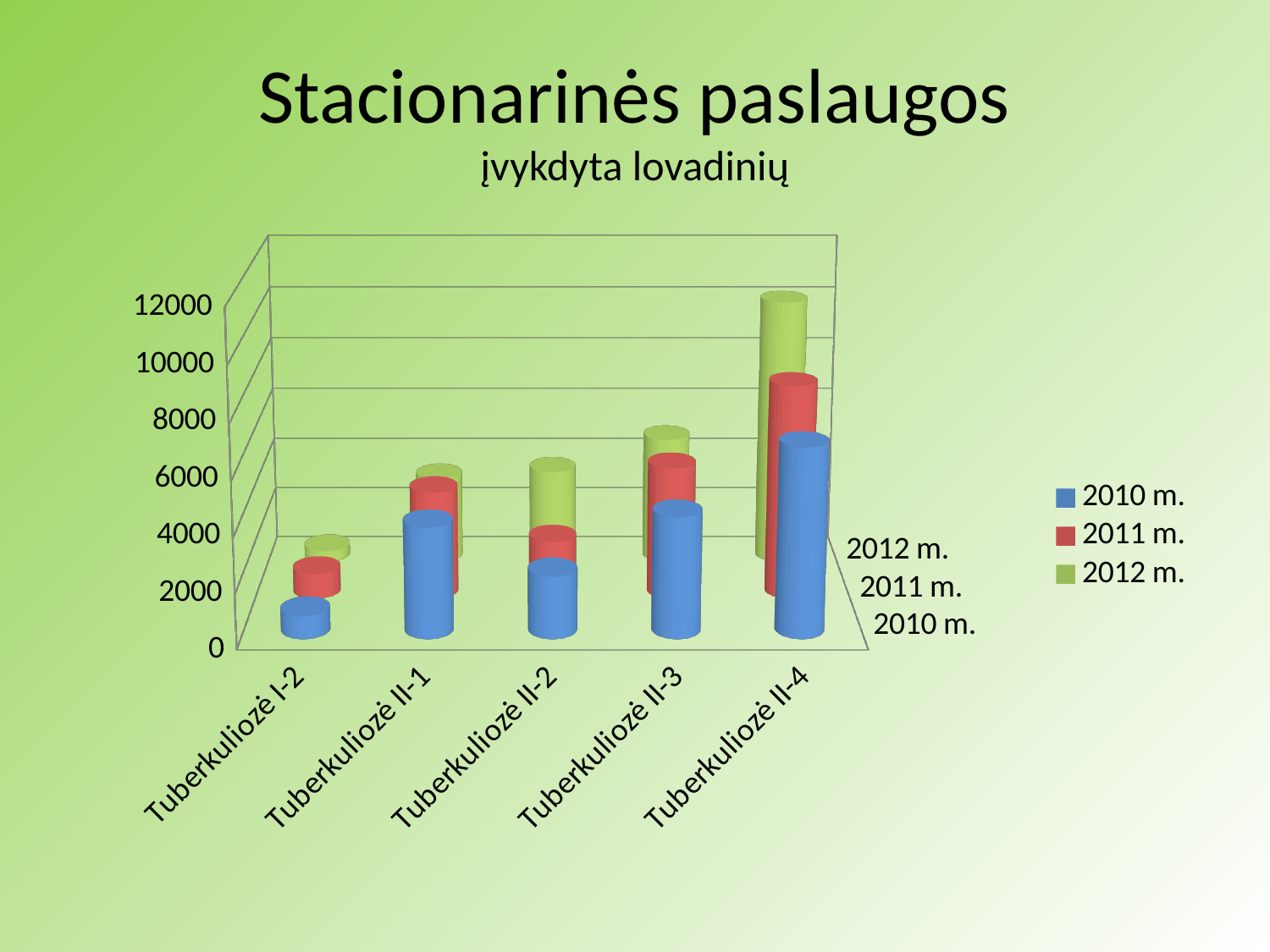
How many series does the legend list? 3 Is the 2010 m. value for Tuberkuliozė I-2 greater or less than 2000? less Which category has the highest value for the 2012 m. series? Tuberkuliozė II-4 Is the 2010 m. value for Tuberkuliozė II-4 greater or less than 4000? greater What kind of chart is shown on the slide? bar chart Which category has the lowest value for the 2010 m. series? Tuberkuliozė I-2 For the 2010 m. series, which is larger: Tuberkuliozė II-1 or Tuberkuliozė II-2? Tuberkuliozė II-1 What is the title of the chart on the slide? Stacionarinės paslaugos Which colour represents the 2011 m. series in the legend? red How many categories are shown on the x axis of the chart? 5 Is the 2012 m. value for Tuberkuliozė II-4 greater or less than 6000? greater Which category has the highest value for the 2011 m. series? Tuberkuliozė II-4